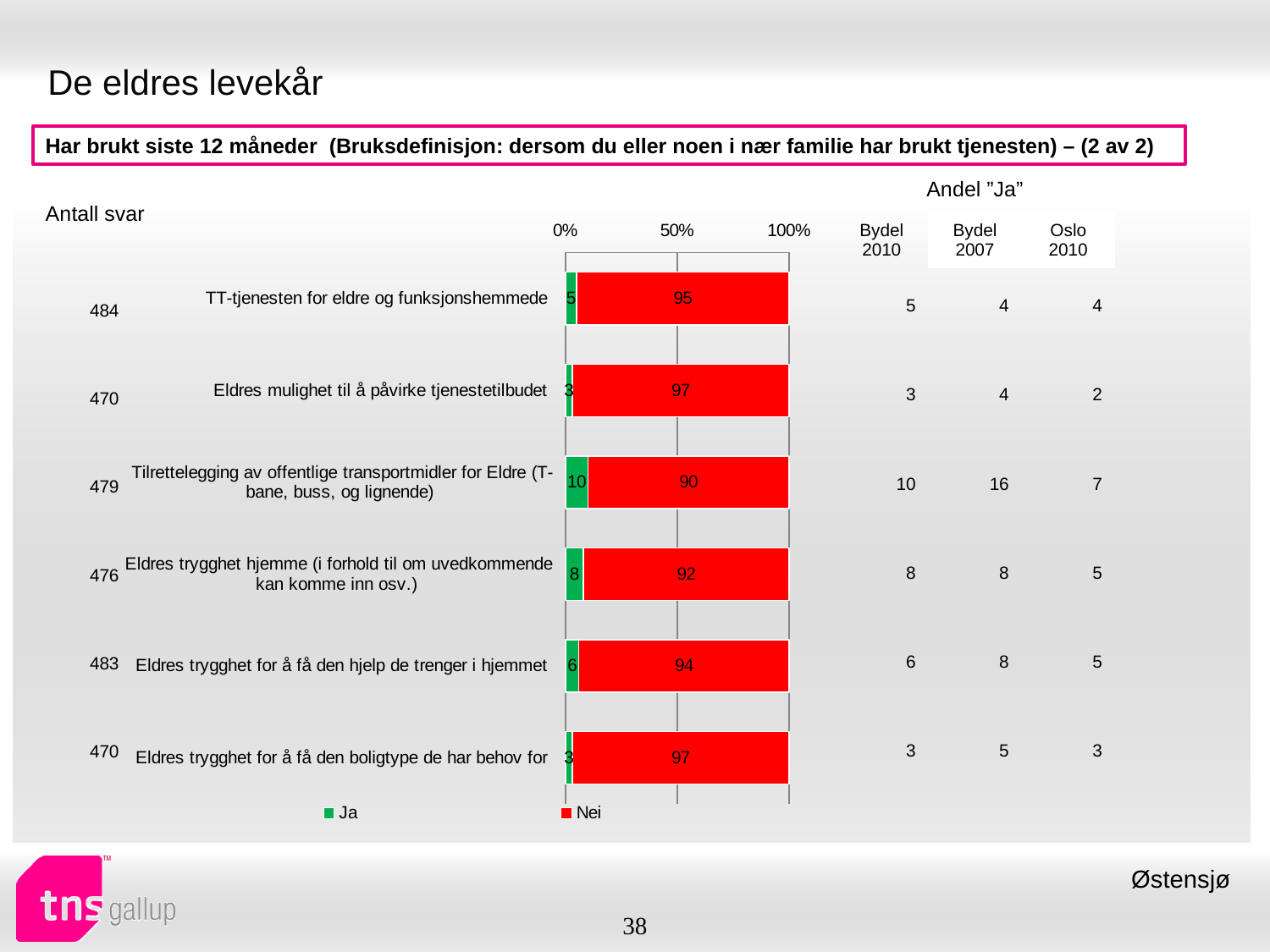
How many series does the chart legend list? 2 Which category has the highest "Ja" value? Tilrettelegging av offentlige transportmidler for Eldre (T-bane, buss, og lignende) What kind of chart is shown on the slide? Stacked bar chart What is the difference between the "Nei" values for "Eldres mulighet til å påvirke tjenestetilbudet" and "Eldres trygghet for å få den hjelp de trenger i hjemmet"? 3 Which colour represents the "Nei" series in the chart? Red Which category has the lowest "Nei" value? Tilrettelegging av offentlige transportmidler for Eldre (T-bane, buss, og lignende) Which is larger: the "Ja" value for "Eldres trygghet hjemme (i forhold til om uvedkommende kan komme inn osv.)" or the "Ja" value for "TT-tjenesten for eldre og funksjonshemmede"? Eldres trygghet hjemme (i forhold til om uvedkommende kan komme inn osv.) What is the "Ja" value for "Tilrettelegging av offentlige transportmidler for Eldre (T-bane, buss, og lignende)"? 10 What is the "Nei" value for "TT-tjenesten for eldre og funksjonshemmede"? 95 What is the total of the stacked bar for "Eldres trygghet for å få den hjelp de trenger i hjemmet"? 100 What is the "Nei" value for "Eldres trygghet hjemme (i forhold til om uvedkommende kan komme inn osv.)"? 92 How many categories are plotted in the chart? 6